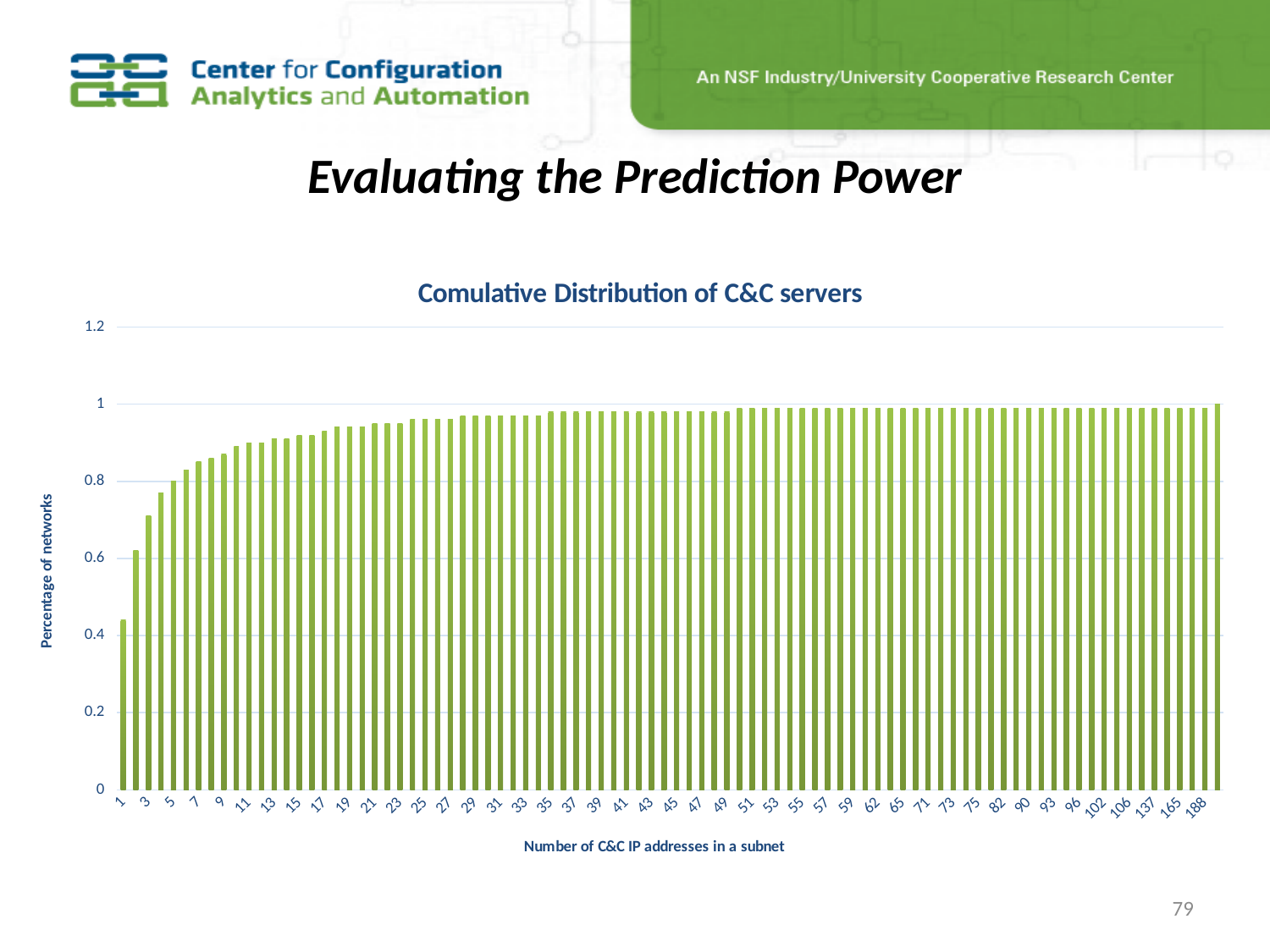
Which has the larger value, the bar for 1 or the bar for 3? 3 Which x-axis category has the lowest value? 1 Is the value for 1 on the x axis greater or less than 0.6? less Is the value for 3 on the x axis greater or less than 0.6? greater Which has the larger value, the bar for 9 or the bar for 1? 9 Do the bar values rise or fall as you move from left to right along the x axis? rise Is the value for 188 on the x axis greater or less than 0.8? greater What is the label of the x axis of the chart? Number of C&C IP addresses in a subnet What is the title of the chart? Comulative Distribution of C&C servers What kind of chart is shown on the slide? bar chart